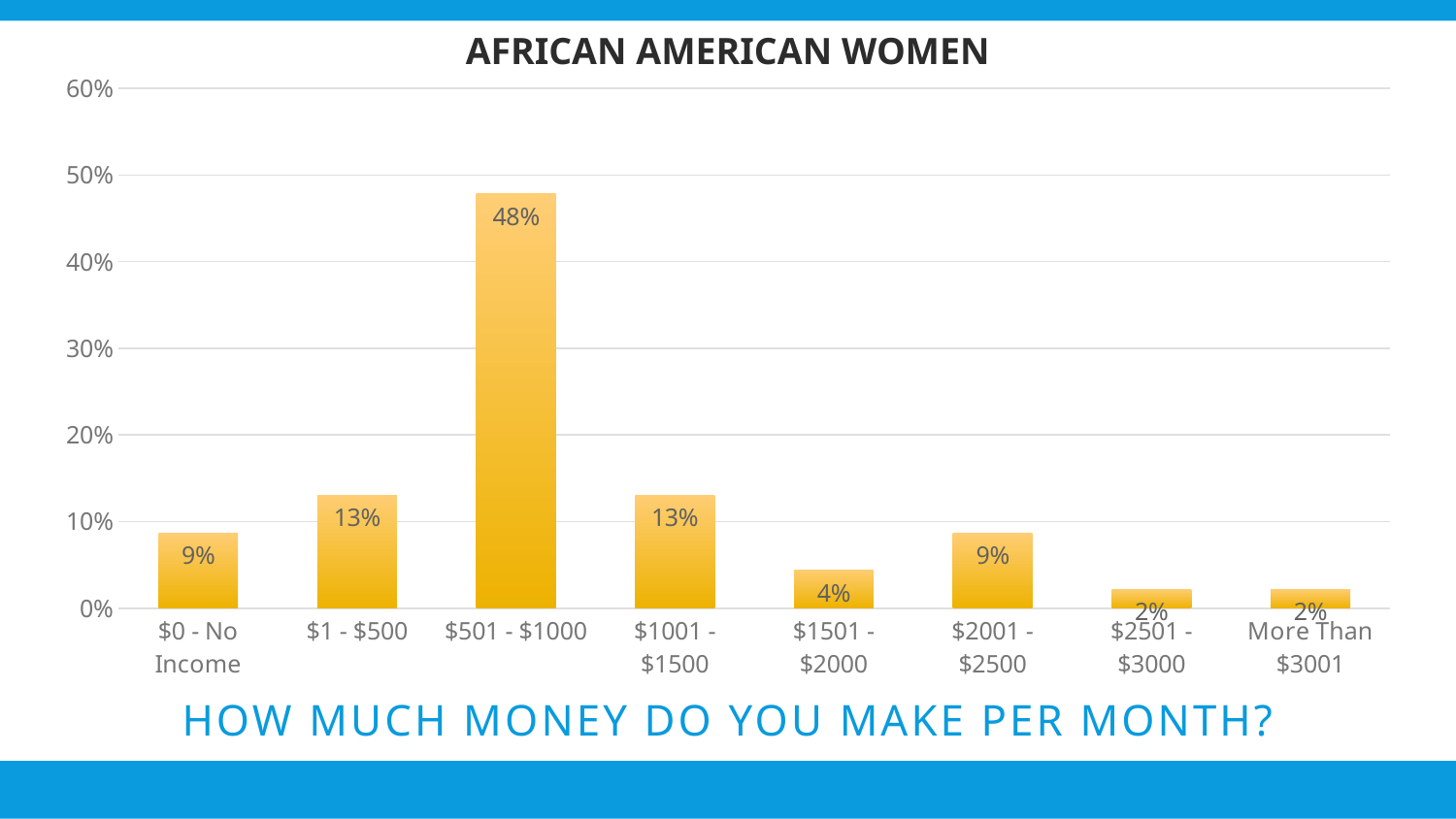
What is the value for the $0 - No Income category? 9% What is the highest value shown on the y axis? 60% What percentage is shown for the $1501 - $2000 category? 4% Is the value for $501 - $1000 greater or less than 40%? greater Which income category has the highest value? $501 - $1000 How many income categories are shown on the x axis? 8 What percentage of African American women reported making $501 - $1000 per month? 48% What is the difference between the $1 - $500 value and the $0 - No Income value? 4% What is the title of the chart? AFRICAN AMERICAN WOMEN What kind of chart is shown on the slide? Bar chart What is the difference between the $501 - $1000 value and the $1001 - $1500 value? 35% Which is larger, the value for $2001 - $2500 or the value for $1501 - $2000? $2001 - $2500